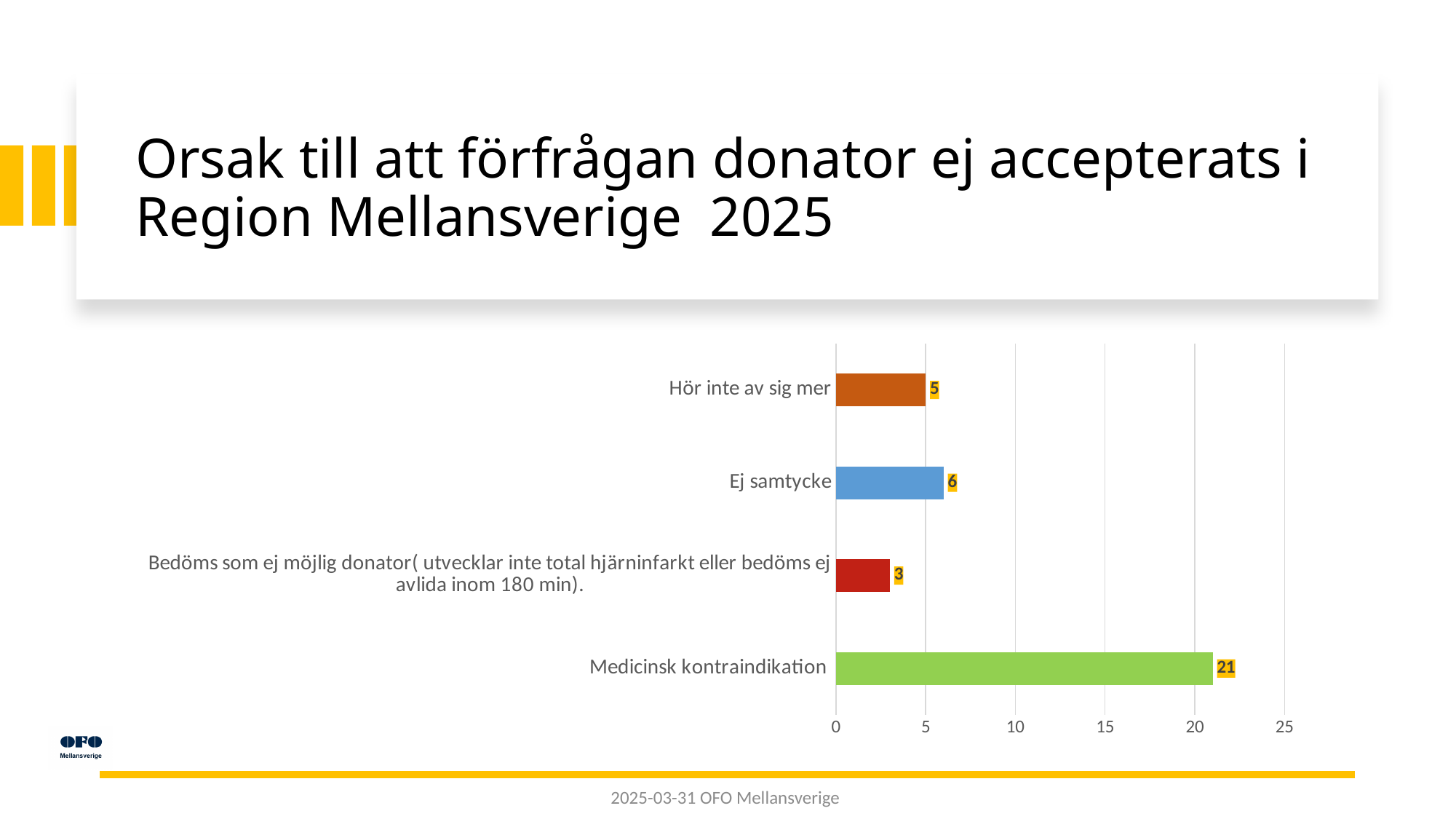
What is the value for Medicinsk kontraindikation? 21 What is the difference between the values for Medicinsk kontraindikation and Ej samtycke? 15 Which category has the highest value? Medicinsk kontraindikation What kind of chart is shown on the slide? Bar chart Is the value for Medicinsk kontraindikation greater or less than 20? greater What is the value for Hör inte av sig mer? 5 What is the value for the category 'Bedöms som ej möjlig donator'? 3 Which is larger, the value for Ej samtycke or the value for Hör inte av sig mer? Ej samtycke What is the value for Ej samtycke? 6 Which category has the lowest value? Bedöms som ej möjlig donator( utvecklar inte total hjärninfarkt eller bedöms ej avlida inom 180 min). What is the highest value shown on the x axis? 25 How many categories are shown in the chart? 4